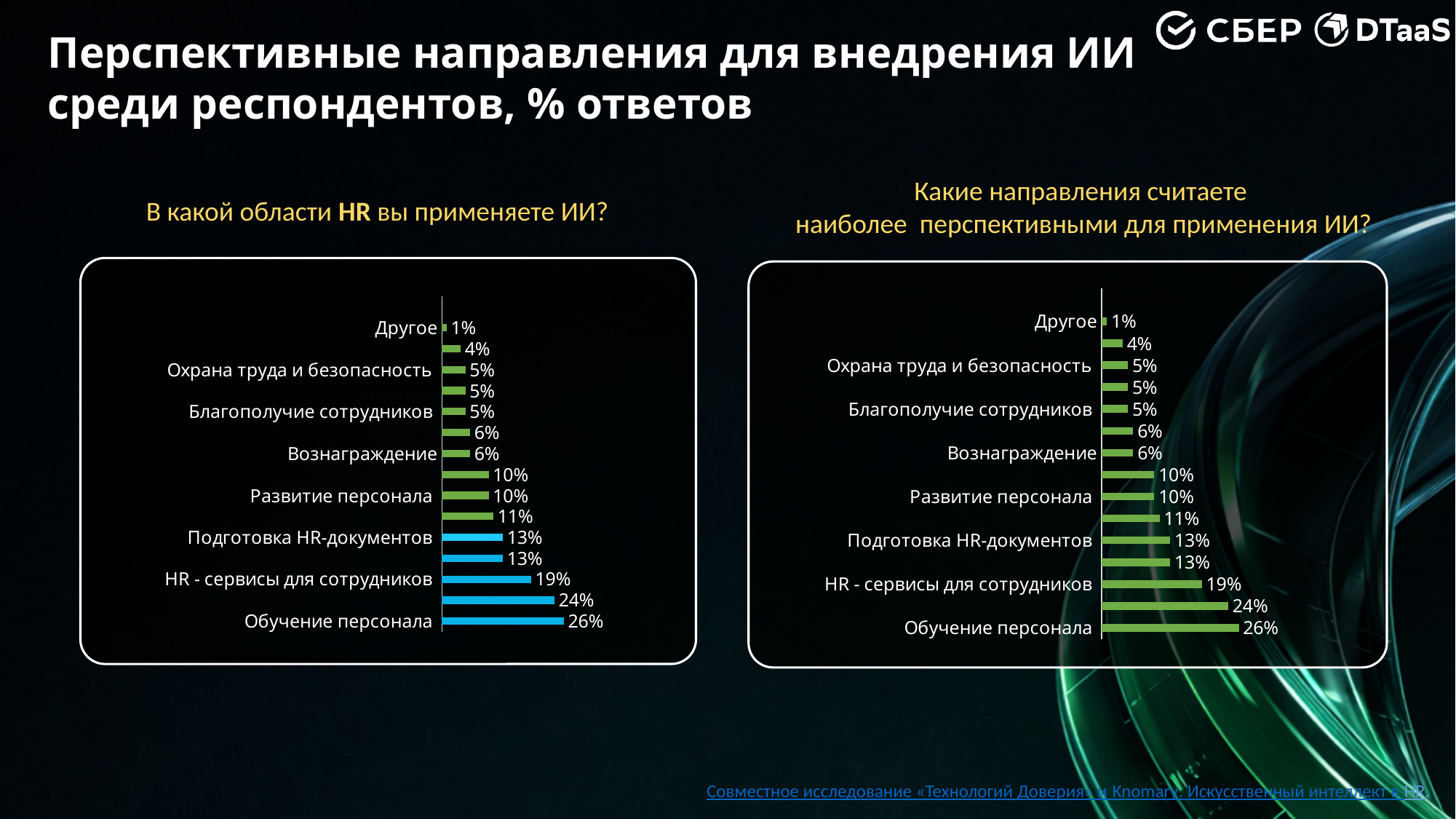
In the left chart, which labeled category has the highest value? Обучение персонала In the left chart (В какой области HR вы применяете ИИ?), what is the value for Обучение персонала? 26% In the left chart, what is the value for Охрана труда и безопасность? 5% In the left chart, what colour are the bars for the four highest values? Blue How many bars are plotted in the right chart? 15 In the right chart, what is the value for Развитие персонала? 10% In the left chart, what is the value for Подготовка HR-документов? 13% In the left chart, what is the difference between the values for Обучение персонала and HR - сервисы для сотрудников? 7% In the right chart, which labeled category has the lowest value? Другое In the right chart (Какие направления считаете наиболее перспективными для применения ИИ?), what is the value for HR - сервисы для сотрудников? 19% What type of chart is used on the left side of the slide? Bar chart In the right chart, which is larger: the value for Вознаграждение or the value for Развитие персонала? Развитие персонала